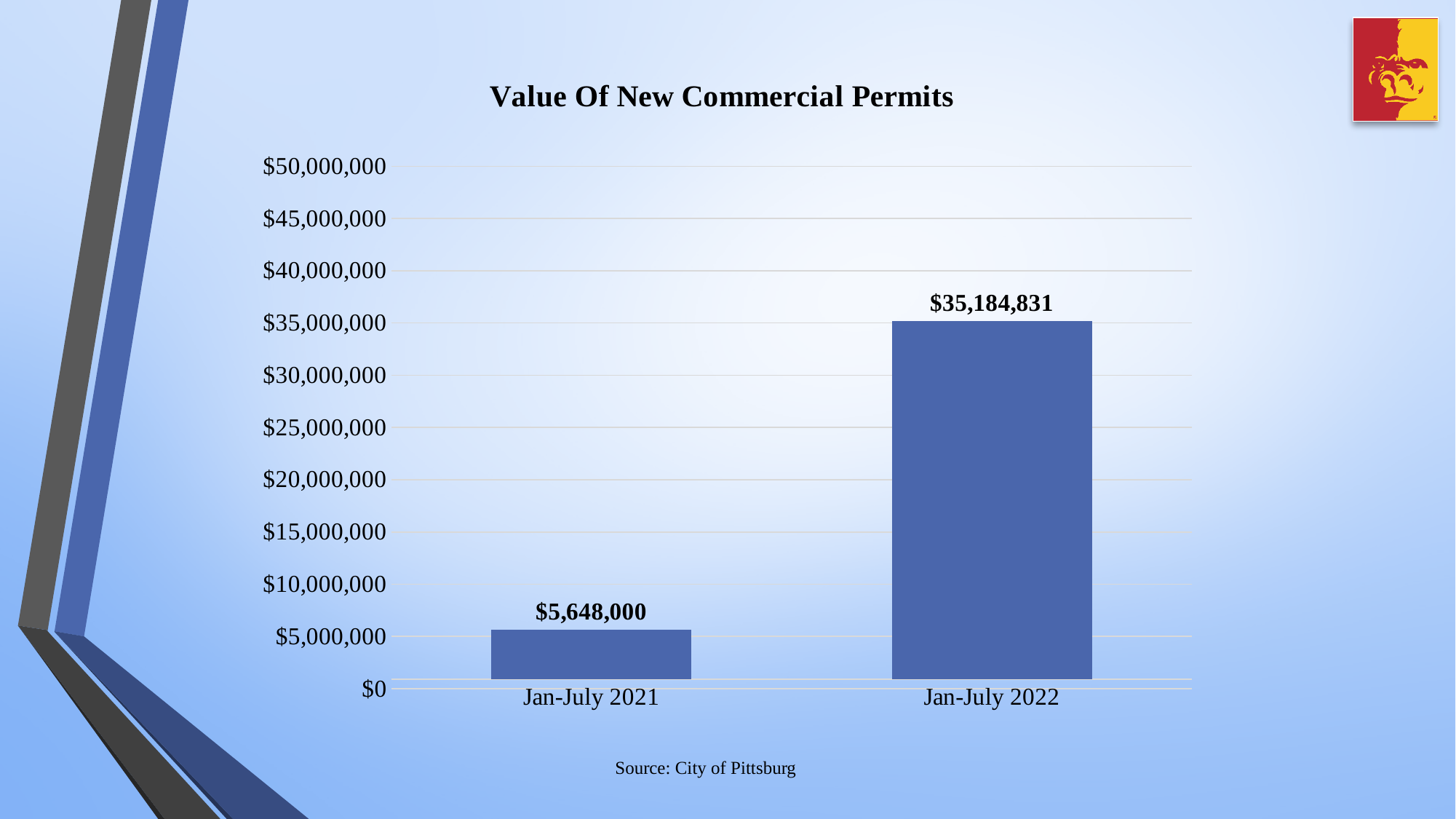
Which period has the highest value of new commercial permits? Jan-July 2022 What is the title of the chart? Value Of New Commercial Permits What kind of chart is shown on the slide? bar chart What is the value of new commercial permits for Jan-July 2021? $5,648,000 Which period has the lowest value of new commercial permits? Jan-July 2021 What is the difference between the Jan-July 2022 and Jan-July 2021 values? $29,536,831 Is the value for Jan-July 2021 greater or less than $10,000,000? less Is the value for Jan-July 2022 greater or less than $30,000,000? greater Do the values rise or fall from Jan-July 2021 to Jan-July 2022? rise How many periods are shown on the chart? 2 What is the value of new commercial permits for Jan-July 2022? $35,184,831 Which is larger, the value for Jan-July 2021 or Jan-July 2022? Jan-July 2022